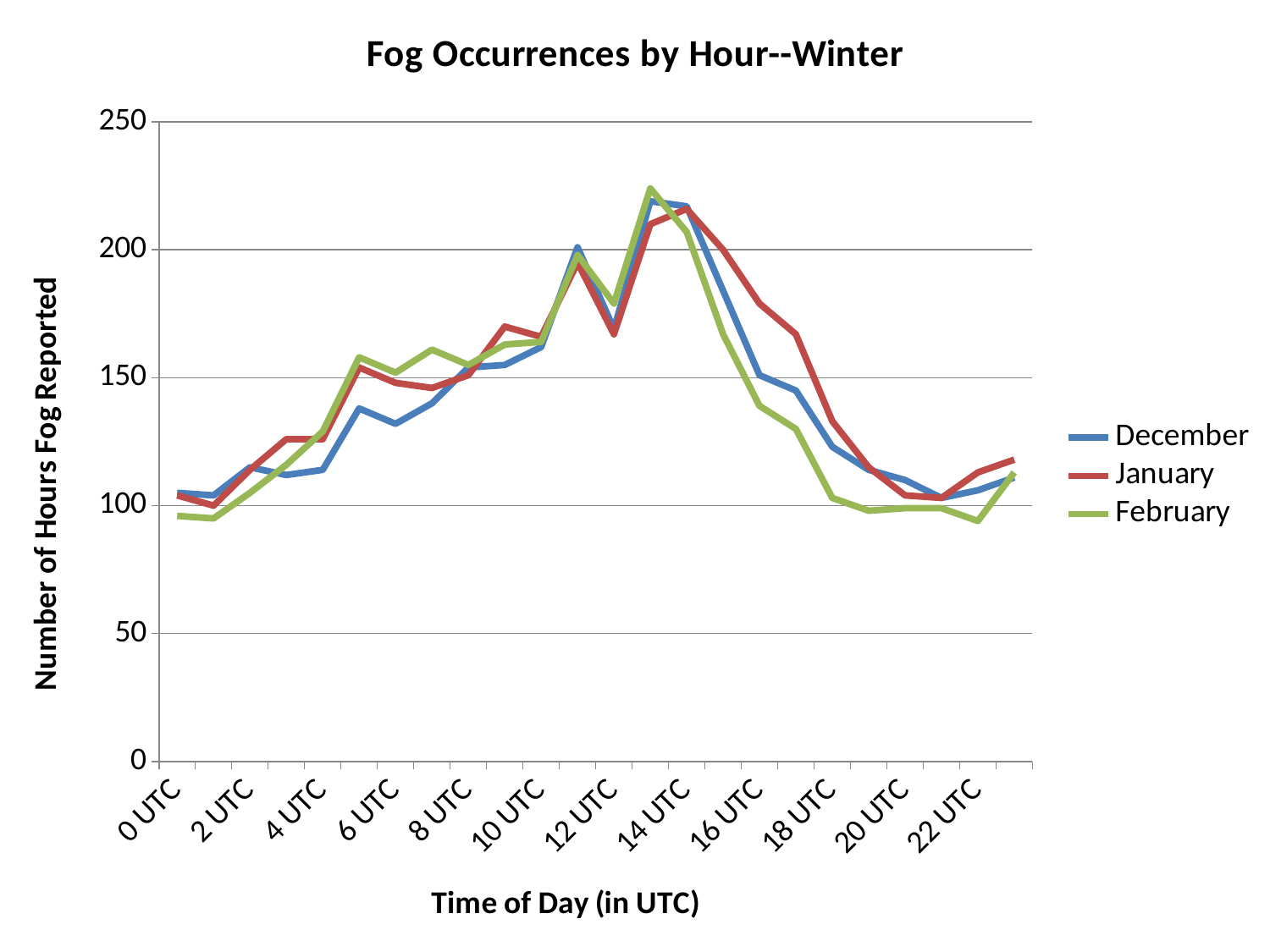
Is the value for December at 14 UTC greater or less than 200? greater What is the title of the chart? Fog Occurrences by Hour--Winter Is the value for January at 18 UTC greater or less than 150? less Is the value for December at 4 UTC greater or less than 150? less Which series has the lowest value at 16 UTC? February Which series has the highest value at 18 UTC? January Does the December series generally rise or fall between 14 UTC and 20 UTC? fall How many series does the legend list? 3 What is the label of the vertical axis? Number of Hours Fog Reported What kind of chart is shown on the slide? line chart